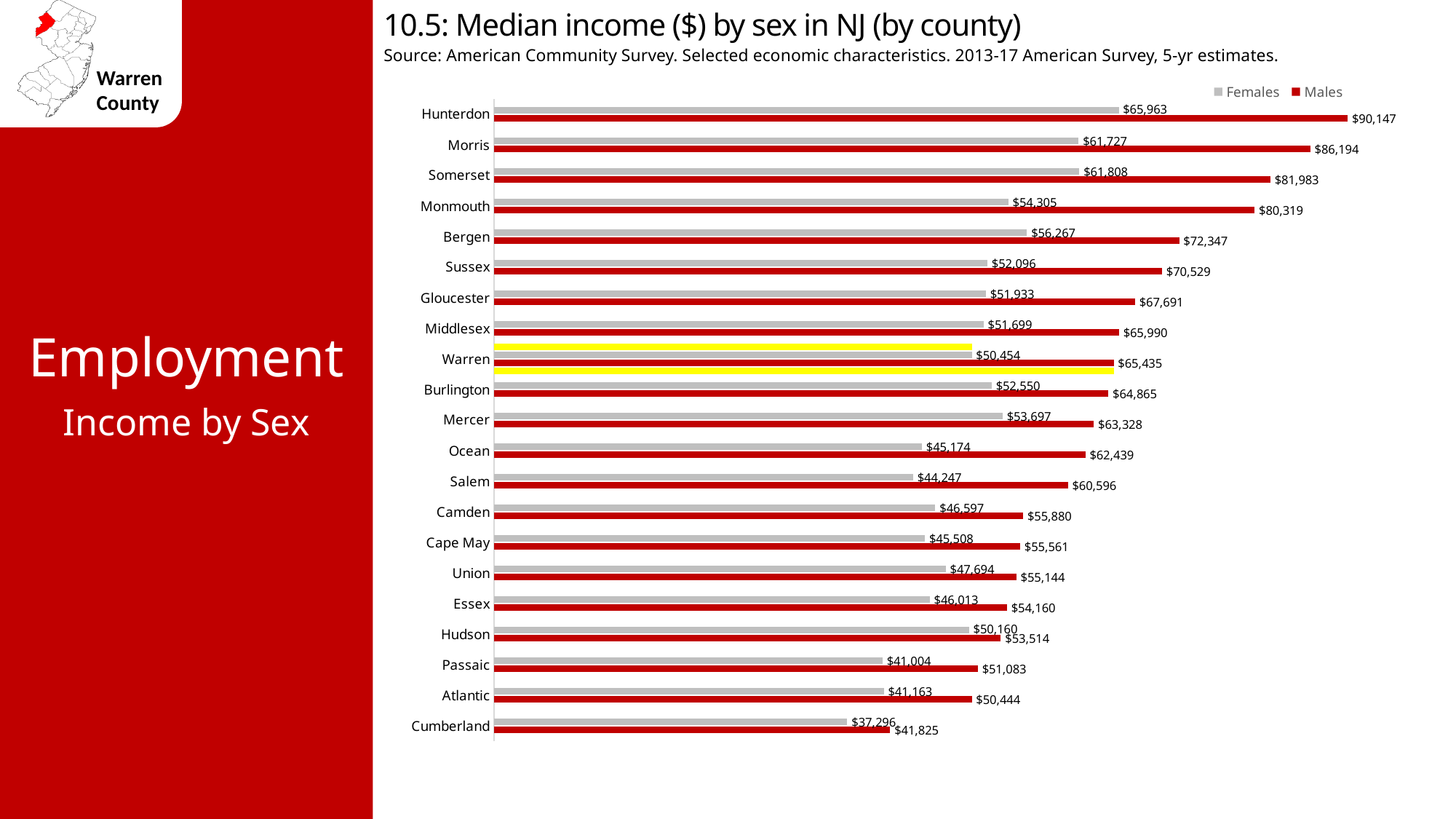
What is the median income for males in Warren County? $65,435 What is the median income for males in Cumberland County? $41,825 What is the difference between male and female median income in Warren County? $14,981 What kind of chart is shown on the slide? Bar chart Which county has the highest median income for males? Hunterdon How many series does the legend list? 2 What is the median income for females in Hunterdon County? $65,963 How many counties are shown in the chart? 21 What is the difference between male and female median income in Hunterdon County? $24,184 Which county has the lowest median income for females? Cumberland Which county's bars are highlighted in yellow on the chart? Warren Which is larger, the female median income in Bergen County or in Sussex County? Bergen County